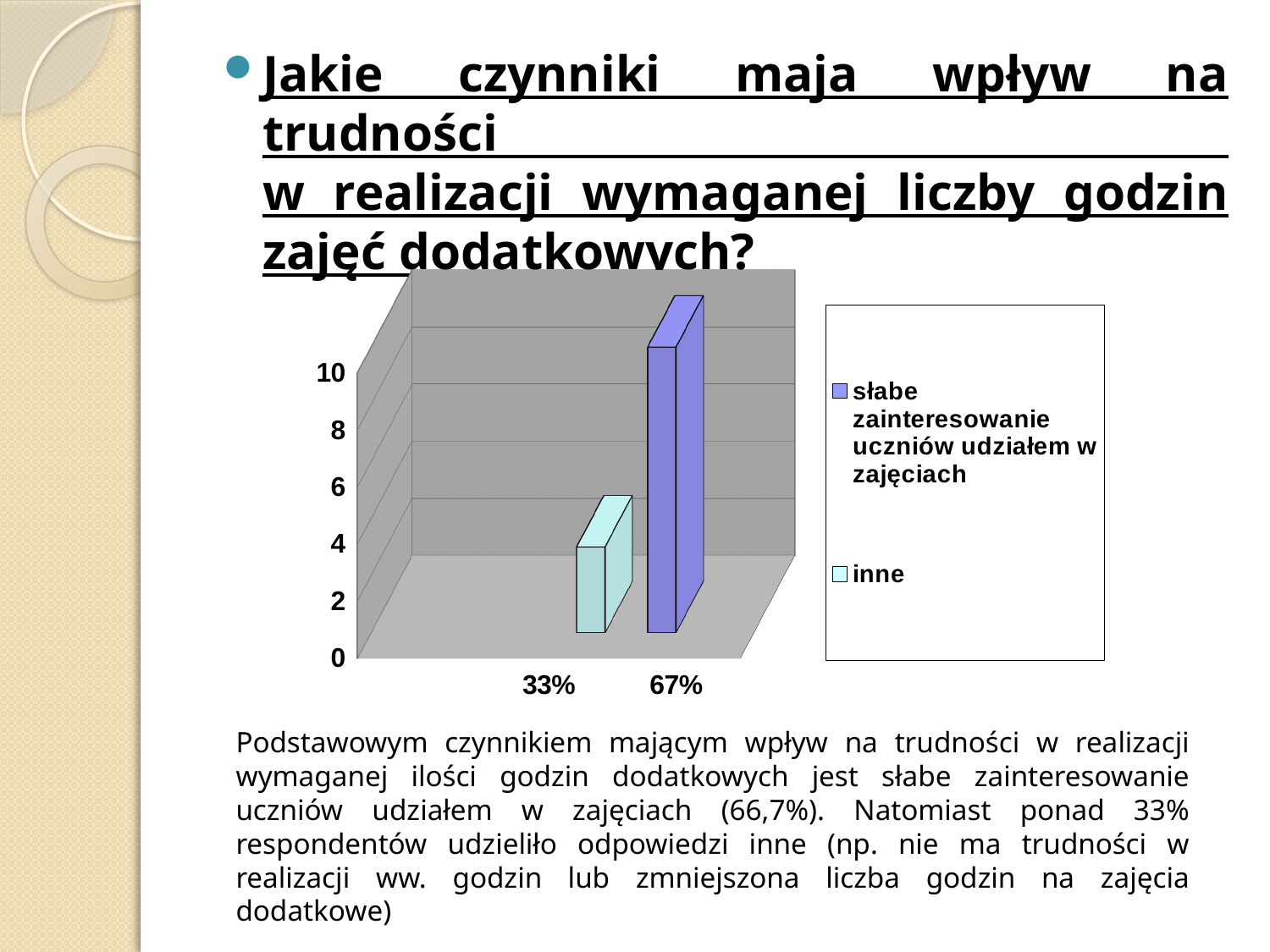
What colour is the bar for "inne" in the chart? light blue Which series has the shortest bar in the chart? inne What kind of chart is shown on the slide? bar chart Which series has the tallest bar in the chart? słabe zainteresowanie uczniów udziałem w zajęciach How many series does the chart legend list? 2 What percentage label is shown under the bar for "inne"? 33% Is the value for "inne" greater or less than 6? less How many bars are plotted in the chart? 2 Which bar is taller: "inne" or "słabe zainteresowanie uczniów udziałem w zajęciach"? słabe zainteresowanie uczniów udziałem w zajęciach What is the highest value shown on the vertical axis of the chart? 10 Is the value for "słabe zainteresowanie uczniów udziałem w zajęciach" greater or less than 8? greater What percentage label is shown under the bar for "słabe zainteresowanie uczniów udziałem w zajęciach"? 67%